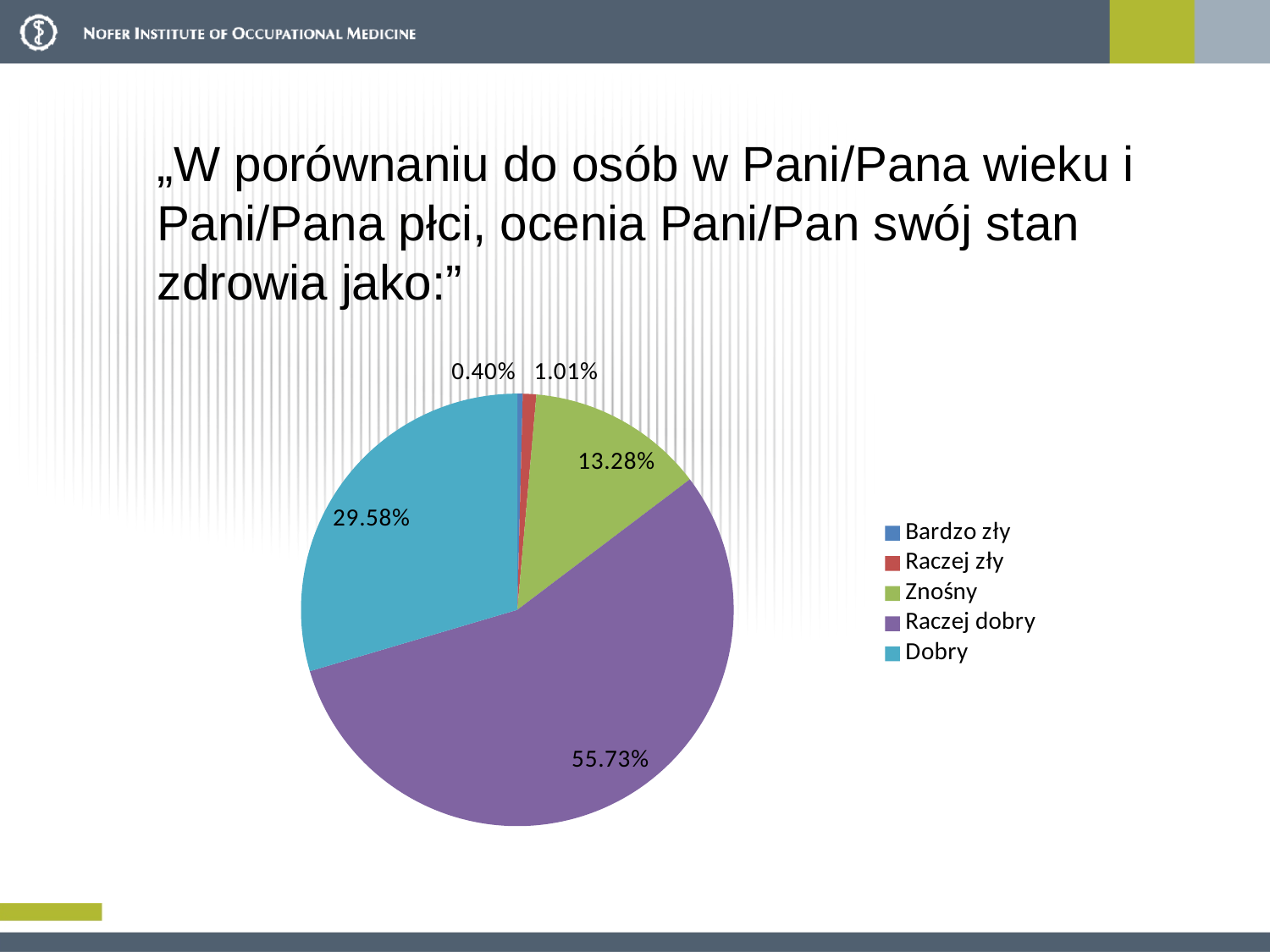
What is the value shown for "Znośny"? 13.28% What is the value shown for "Raczej zły"? 1.01% What kind of chart is shown on the slide? pie chart What colour is the "Raczej dobry" slice? purple What is the value shown for "Bardzo zły"? 0.40% What is the value shown for "Dobry"? 29.58% How many categories does the legend list? 5 Which category has the smallest slice of the pie? Bardzo zły What is the difference between the values for "Raczej dobry" and "Dobry"? 26.15% What share of the pie does the "Raczej dobry" slice represent? 55.73% Which is larger, the value for "Dobry" or the value for "Znośny"? Dobry Which category has the largest slice of the pie? Raczej dobry